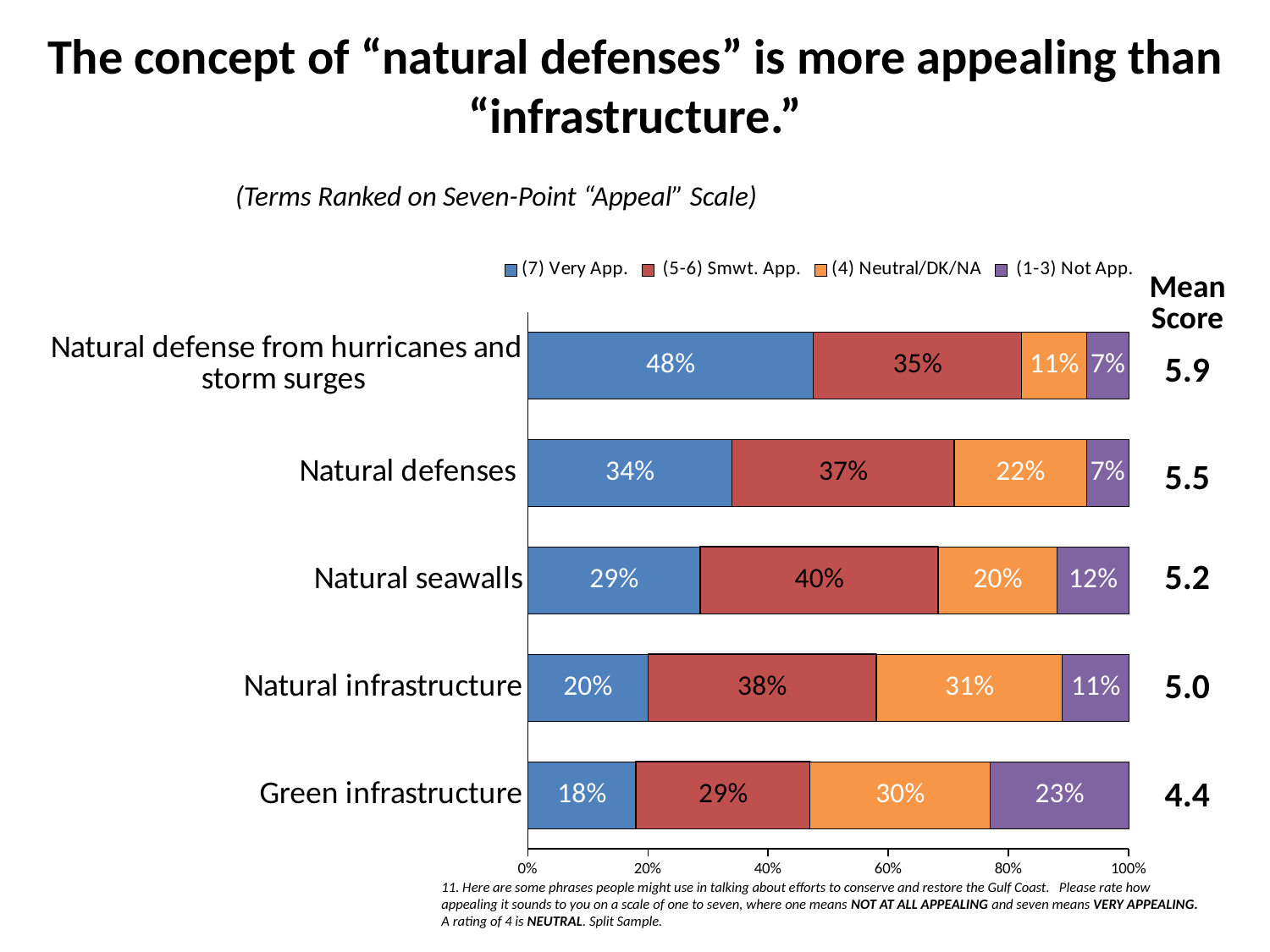
Which category has the lowest (7) Very App. percentage? Green infrastructure What colour represents the (4) Neutral/DK/NA series? Orange What percentage rated "Green infrastructure" as (1-3) Not App.? 23% How many categories are shown on the chart? 5 What kind of chart is shown on the slide? Stacked bar chart What percentage rated "Natural defense from hurricanes and storm surges" as (7) Very App.? 48% What is the (4) Neutral/DK/NA percentage for "Natural infrastructure"? 31% Which has a larger (1-3) Not App. percentage, "Natural seawalls" or "Natural infrastructure"? Natural seawalls What is the Mean Score shown for "Natural seawalls"? 5.2 What is the difference between the (5-6) Smwt. App. percentages for "Natural seawalls" and "Green infrastructure"? 11% How many series does the legend list? 4 Which category has the highest (7) Very App. percentage? Natural defense from hurricanes and storm surges